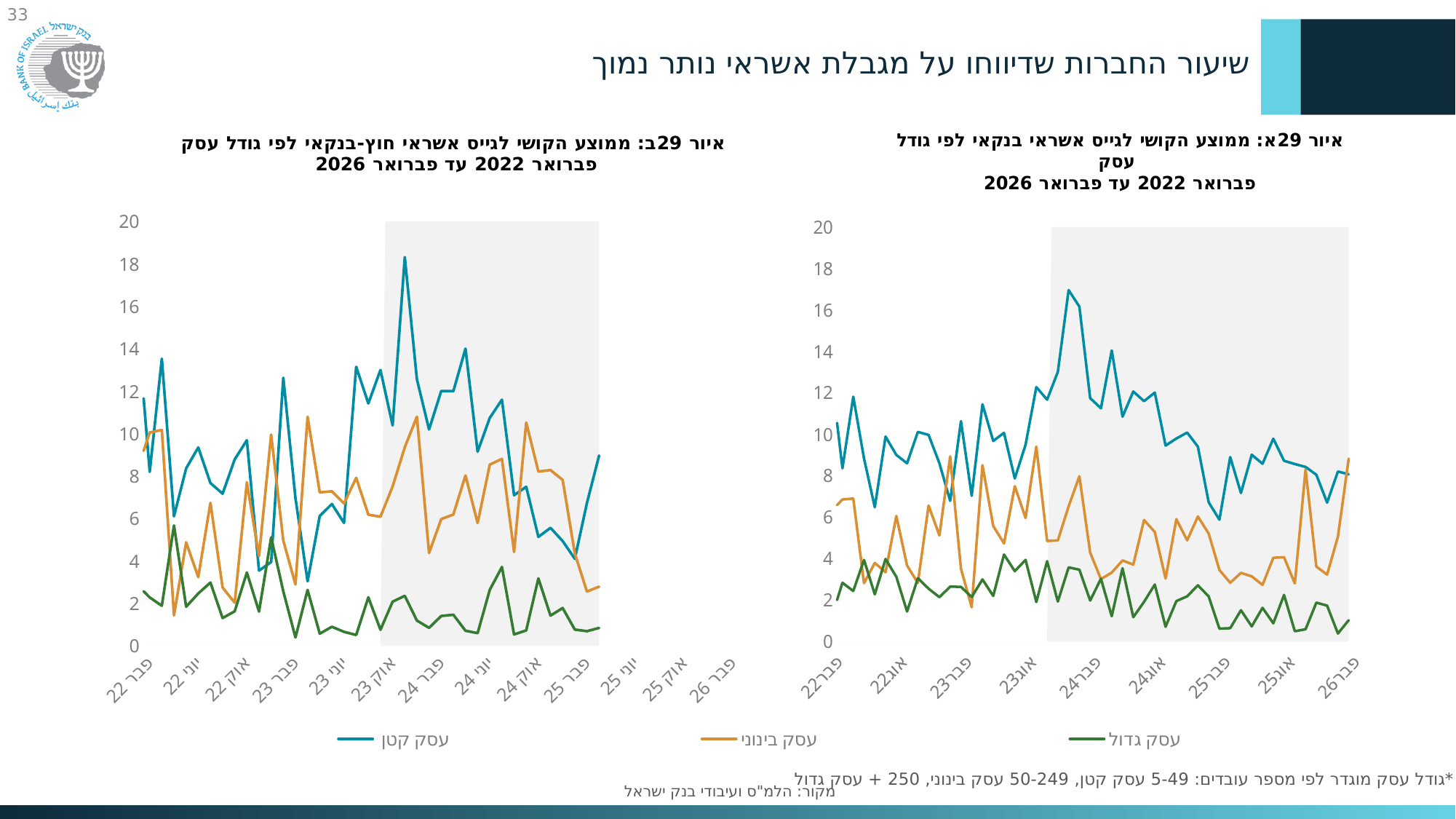
Which series in the legend is drawn in green? עסק גדול In the left chart (איור 29ב), is the peak value of the עסק קטן line greater or less than 16? greater In the left chart (איור 29ב), is the highest value of the עסק גדול line greater or less than 8? less How many series does the shared legend at the bottom of the slide list? 3 In the right chart (איור 29א), is the peak value of the עסק קטן line greater or less than 14? greater What kind of chart is the chart titled 'איור 29ב' on the left side of the slide? line chart In the right chart (איור 29א), does the עסק קטן line generally rise or fall from its peak around פבר 24 to פבר 25? fall What kind of chart is the chart titled 'איור 29א' on the right side of the slide? line chart In the right chart (איור 29א), at the last point (פבר 26), which series is higher: עסק קטן or עסק גדול? עסק קטן Which series in the legend is drawn in orange? עסק בינוני In the left chart (איור 29ב), at the last plotted point (פבר 25), which series is higher: עסק קטן or עסק גדול? עסק קטן